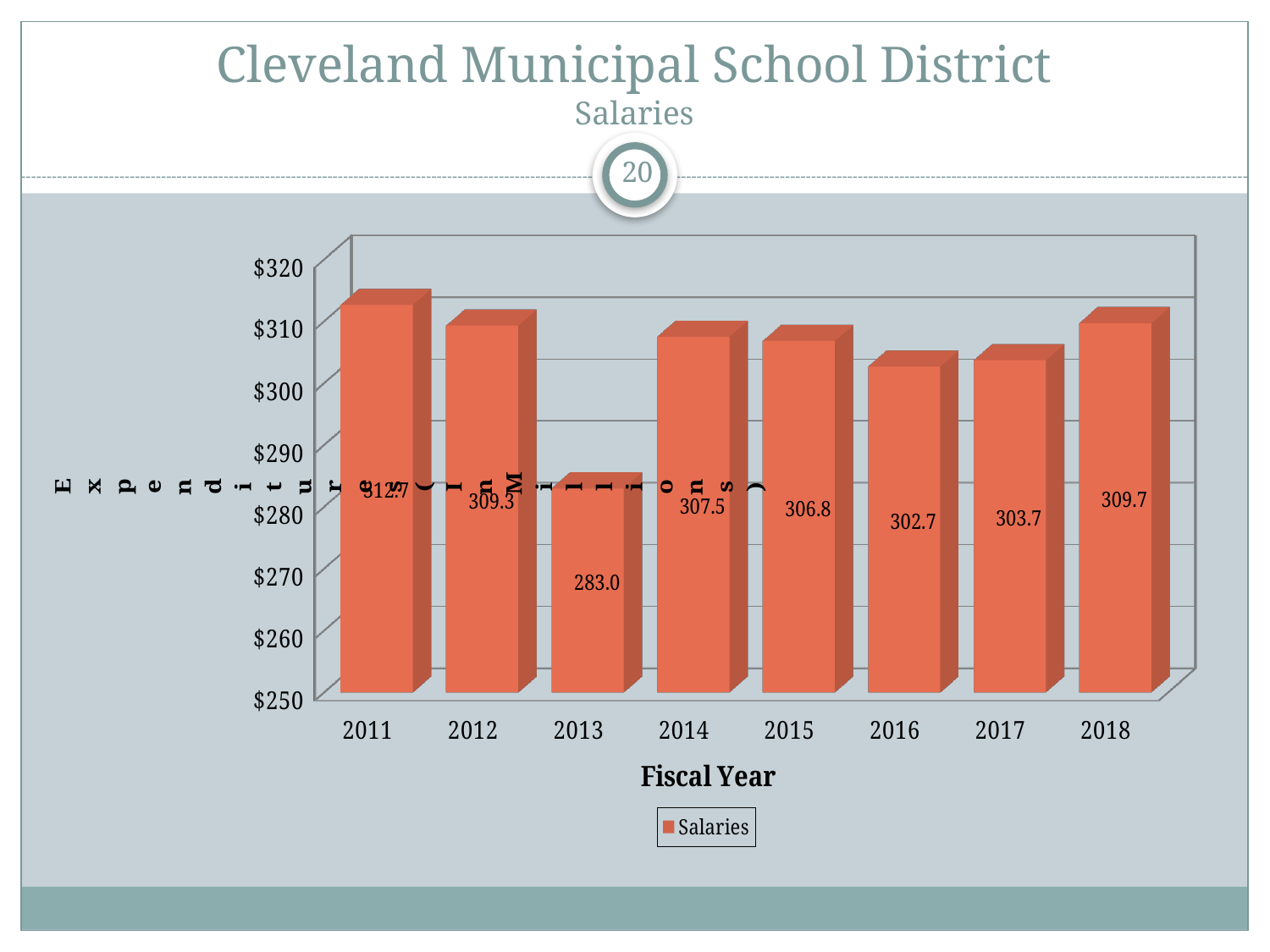
What is the value for 2016? 302.7 What kind of chart is shown on the slide? bar chart How many fiscal years are shown on the x axis? 8 What is the x-axis title of the chart? Fiscal Year What is the difference between the values for 2018 and 2013? 26.7 Is the value for 2013 greater or less than $290? less What is the value for 2013? 283.0 What is the value for 2014? 307.5 Which fiscal year has the highest salaries value? 2011 Which is larger, the value for 2015 or the value for 2017? 2015 What is the value for 2018? 309.7 Which fiscal year has the lowest salaries value? 2013